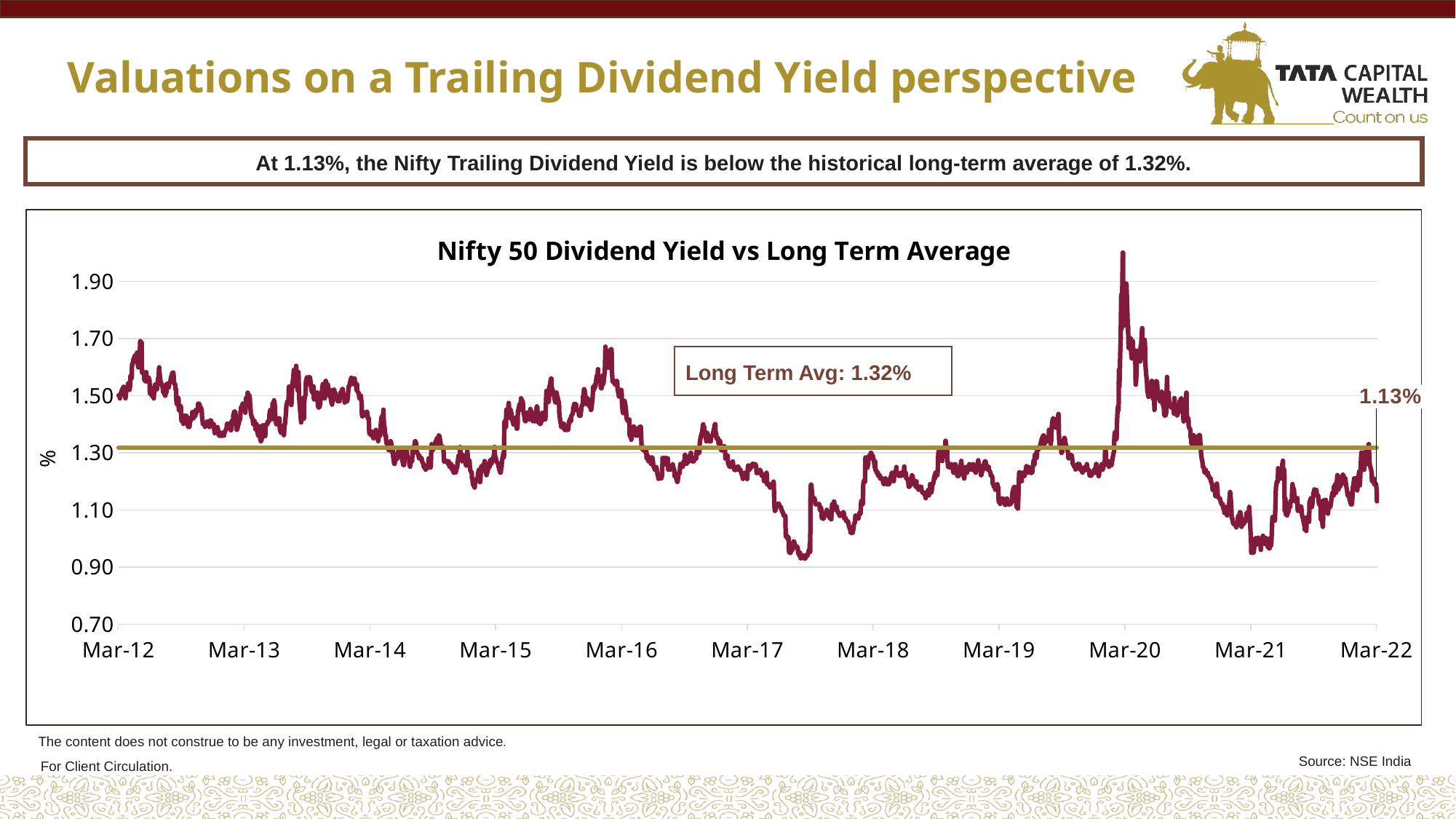
What is the title of the chart? Nifty 50 Dividend Yield vs Long Term Average Is the dividend yield value at Mar-12 greater or less than 1.30? greater Does the dividend yield line rise or fall between its peak near Mar-20 and Mar-21? Fall What kind of chart is shown on the slide? Line chart Near which x-axis label does the dividend yield line reach its highest point? Mar-20 How many date labels are shown on the x axis? 11 What is the long term average dividend yield shown on the chart? 1.32% Is the lowest point of the dividend yield line (between Mar-17 and Mar-18) greater or less than 1.10? less Which is larger, the Mar-22 dividend yield or the long term average? The long term average What is the Nifty 50 dividend yield value labelled at Mar-22? 1.13% By how much is the Mar-22 dividend yield of 1.13% below the long term average of 1.32%? 0.19% Is the peak value of the dividend yield line near Mar-20 greater or less than 1.90? greater